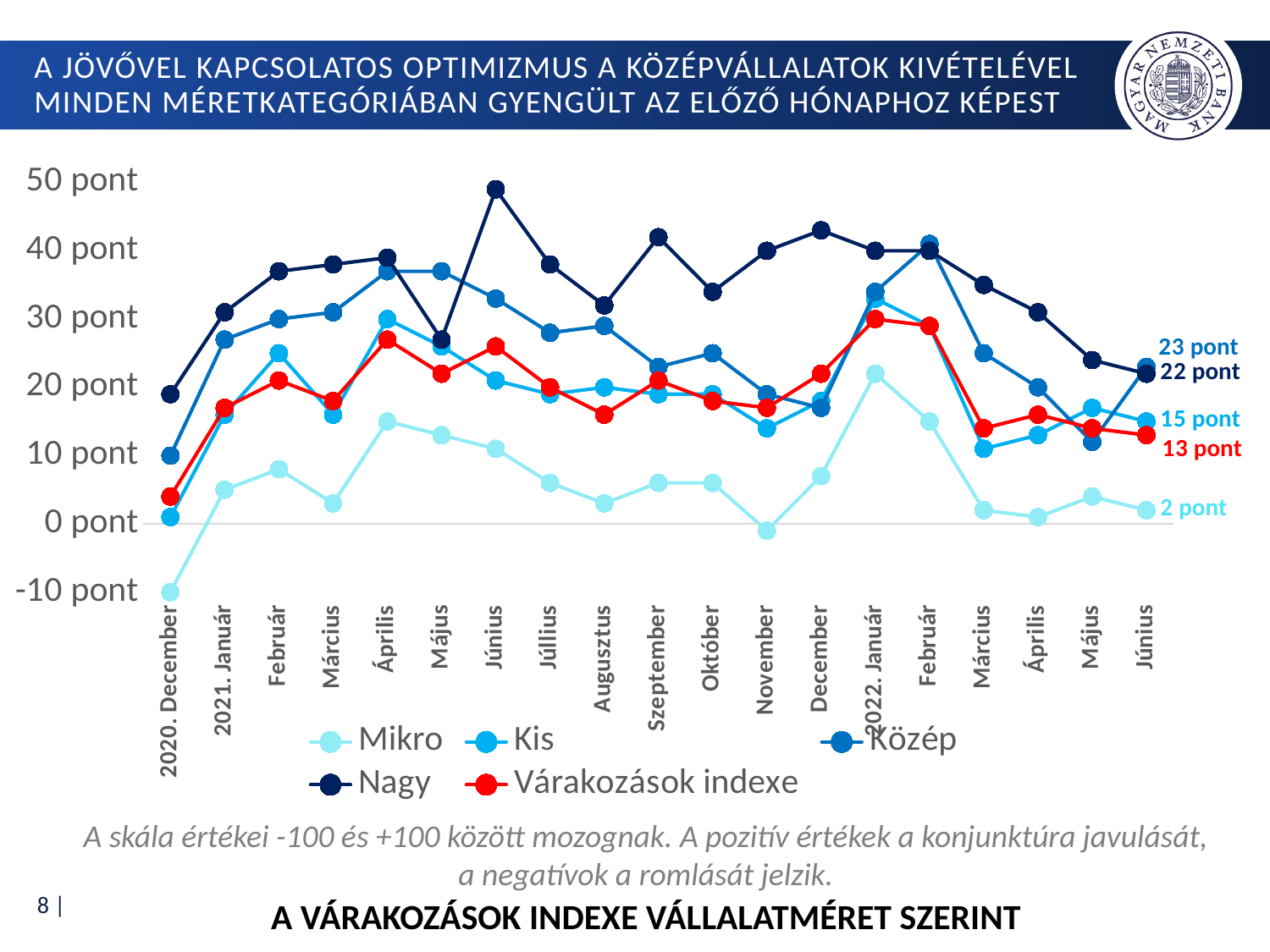
What is the title of the chart? A várakozások indexe vállalatméret szerint In 2022 Június, which is larger: the Kis value or the Várakozások indexe value? Kis What is the value of the Nagy series in 2022 Június? 22 pont How many months are plotted along the x axis? 19 What kind of chart is shown on the slide? line chart Is the value for Nagy in 2021 Június greater or less than 40 pont? greater How many series does the legend list? 5 What is the difference between the Kis and Mikro values in 2022 Június? 13 pont Which series has the lowest value in 2020 December? Mikro What is the value of the Közép series in 2022 Június? 23 pont What is the value of the Mikro series in 2022 Június? 2 pont What is the value of the Várakozások indexe series in 2022 Június? 13 pont